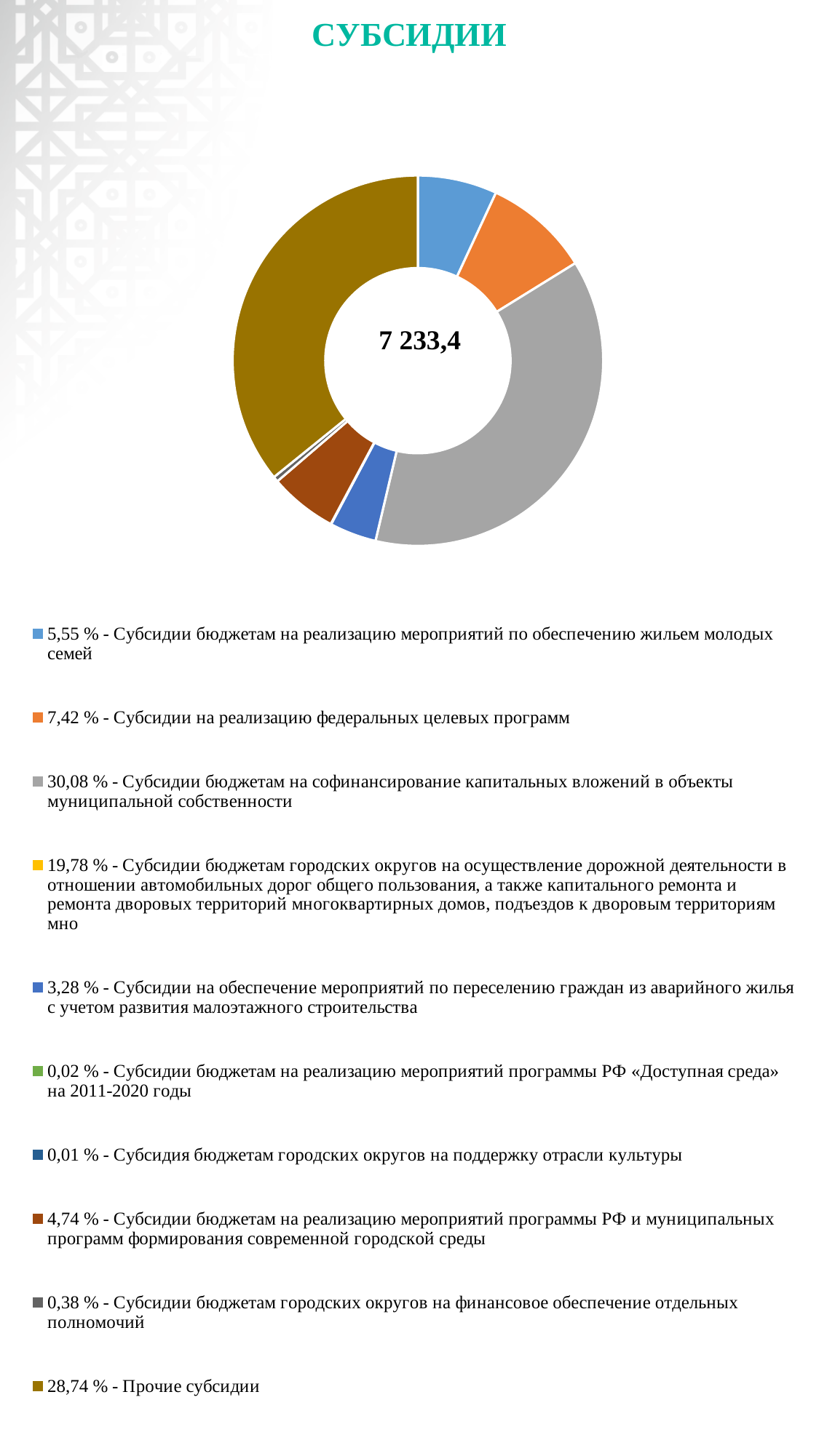
What share is shown for 'Субсидии на обеспечение мероприятий по переселению граждан из аварийного жилья с учетом развития малоэтажного строительства'? 3,28 % What share is shown for 'Субсидии на реализацию федеральных целевых программ'? 7,42 % What is the title of the chart on the slide? СУБСИДИИ Which category has the smallest share according to the legend? Субсидия бюджетам городских округов на поддержку отрасли культуры (0,01 %) What share is shown for 'Прочие субсидии'? 28,74 % Which category has the largest share according to the legend? Субсидии бюджетам на софинансирование капитальных вложений в объекты муниципальной собственности (30,08 %) How many categories does the legend list? 10 What value is printed in the centre of the doughnut chart? 7 233,4 What kind of chart is shown on the slide? doughnut (pie) chart Which is larger: the share for 'Субсидии на реализацию федеральных целевых программ' or the share for 'Субсидии бюджетам на реализацию мероприятий по обеспечению жильем молодых семей'? Субсидии на реализацию федеральных целевых программ What is the difference in percentage points between the share for 'Субсидии бюджетам на софинансирование капитальных вложений в объекты муниципальной собственности' and 'Прочие субсидии'? 1,34 %